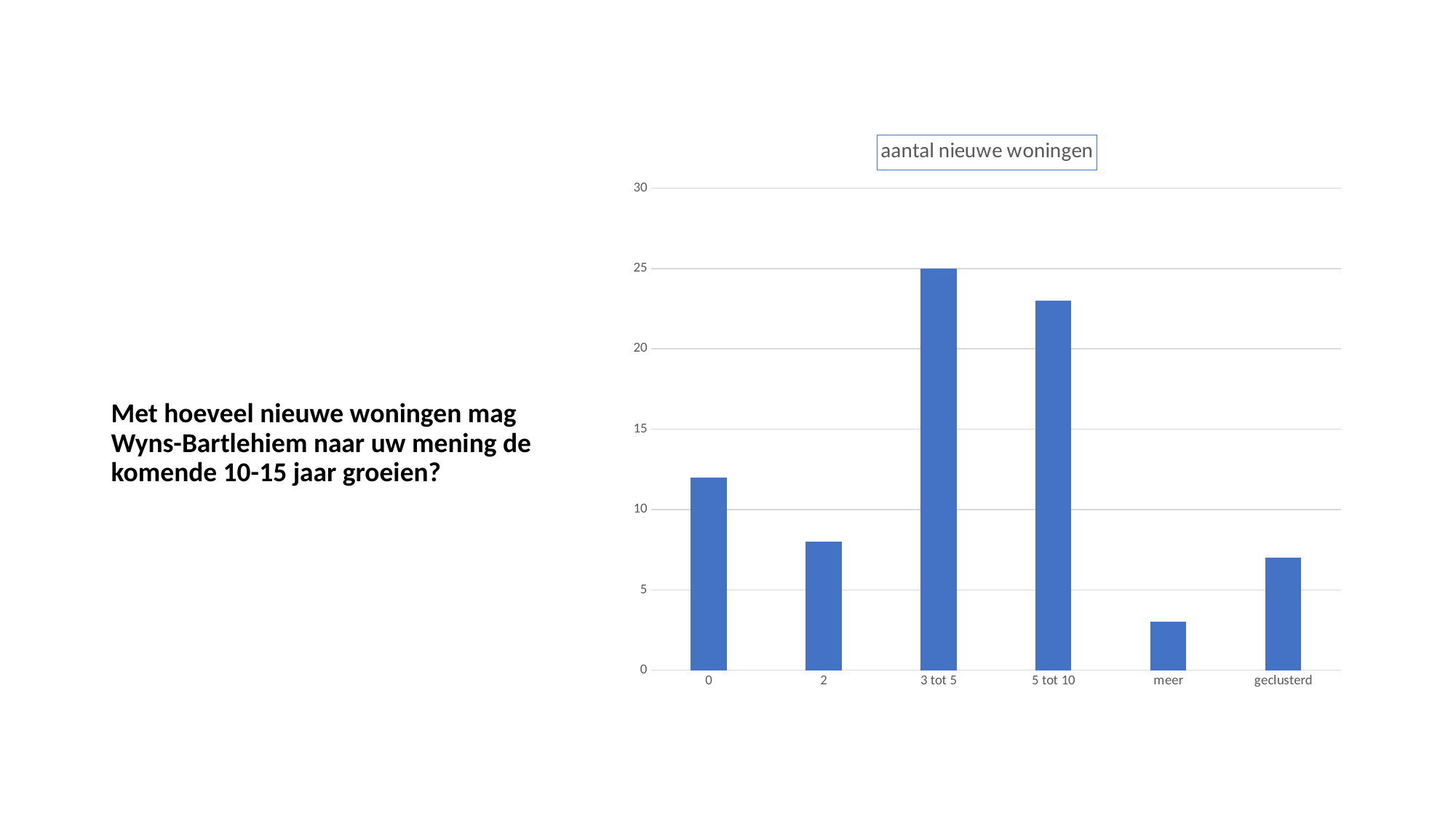
Is the value for the category '2' greater or less than 10? less Which category has the larger value, 'geclusterd' or 'meer'? geclusterd Which category has the lowest bar? meer Is the value for the category '5 tot 10' greater or less than 20? greater Is the value for the category '0' greater or less than 10? greater What kind of chart is shown on the slide? bar chart What is the title of the chart? aantal nieuwe woningen How many categories are shown on the x axis of the chart? 6 What is the value for the category '3 tot 5'? 25 Which category has the highest bar? 3 tot 5 Which category has the larger value, '0' or '2'? 0